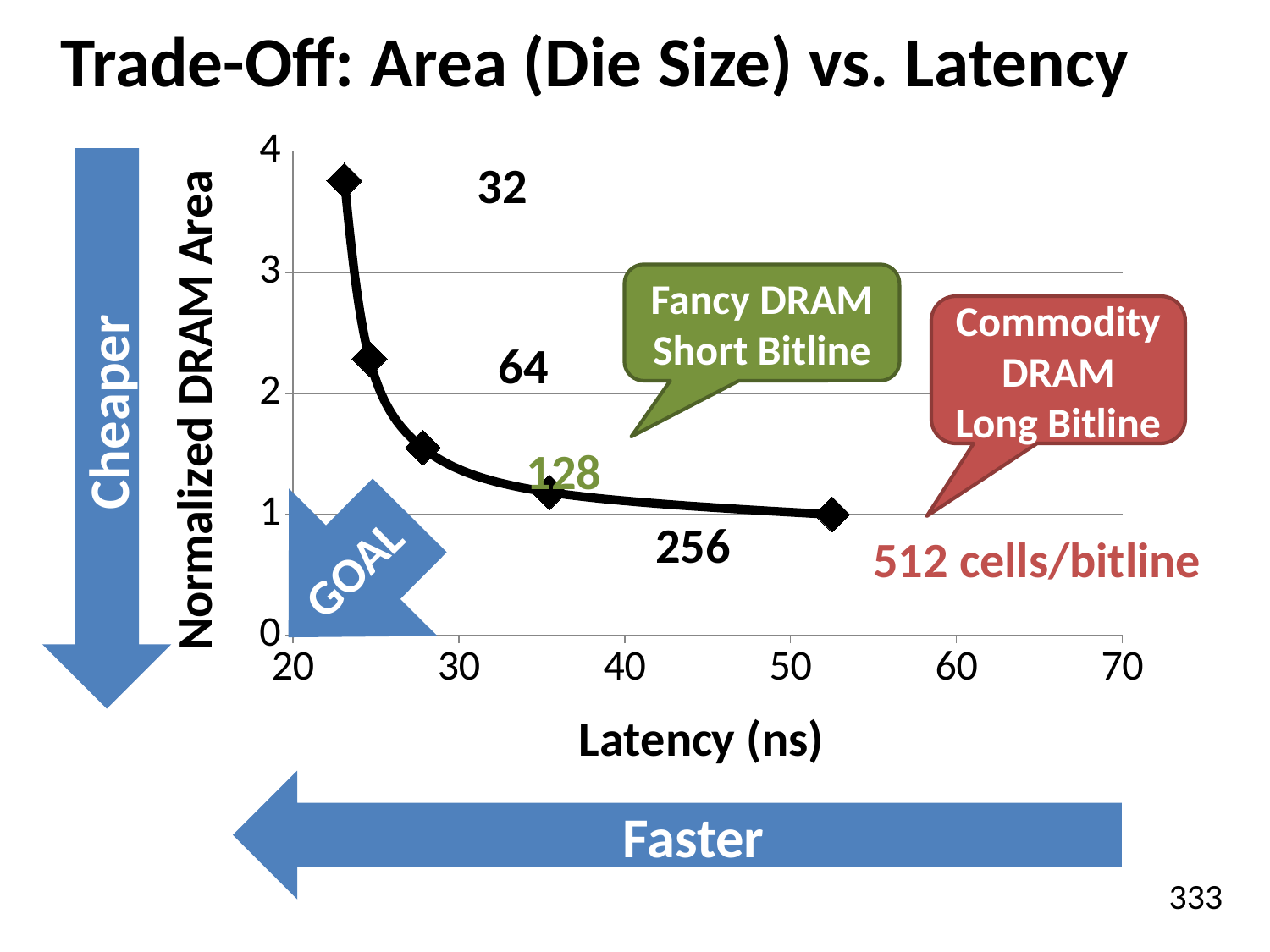
Is the latency for 32 cells/bitline greater or less than 30 ns? less Is the normalized DRAM area for 32 cells/bitline greater or less than 3? greater Is the normalized DRAM area for 128 cells/bitline greater or less than 2? less What kind of chart is shown on the slide? line chart What is the normalized DRAM area for 512 cells/bitline? 1 Which cells/bitline configuration has the lowest normalized DRAM area? 512 As latency increases along the x axis, does the normalized DRAM area rise or fall? fall What is the title of the x axis? Latency (ns) How many data points are plotted on the chart? 5 Which cells/bitline configuration has the highest normalized DRAM area? 32 Which has a larger normalized DRAM area, 64 cells/bitline or 256 cells/bitline? 64 cells/bitline